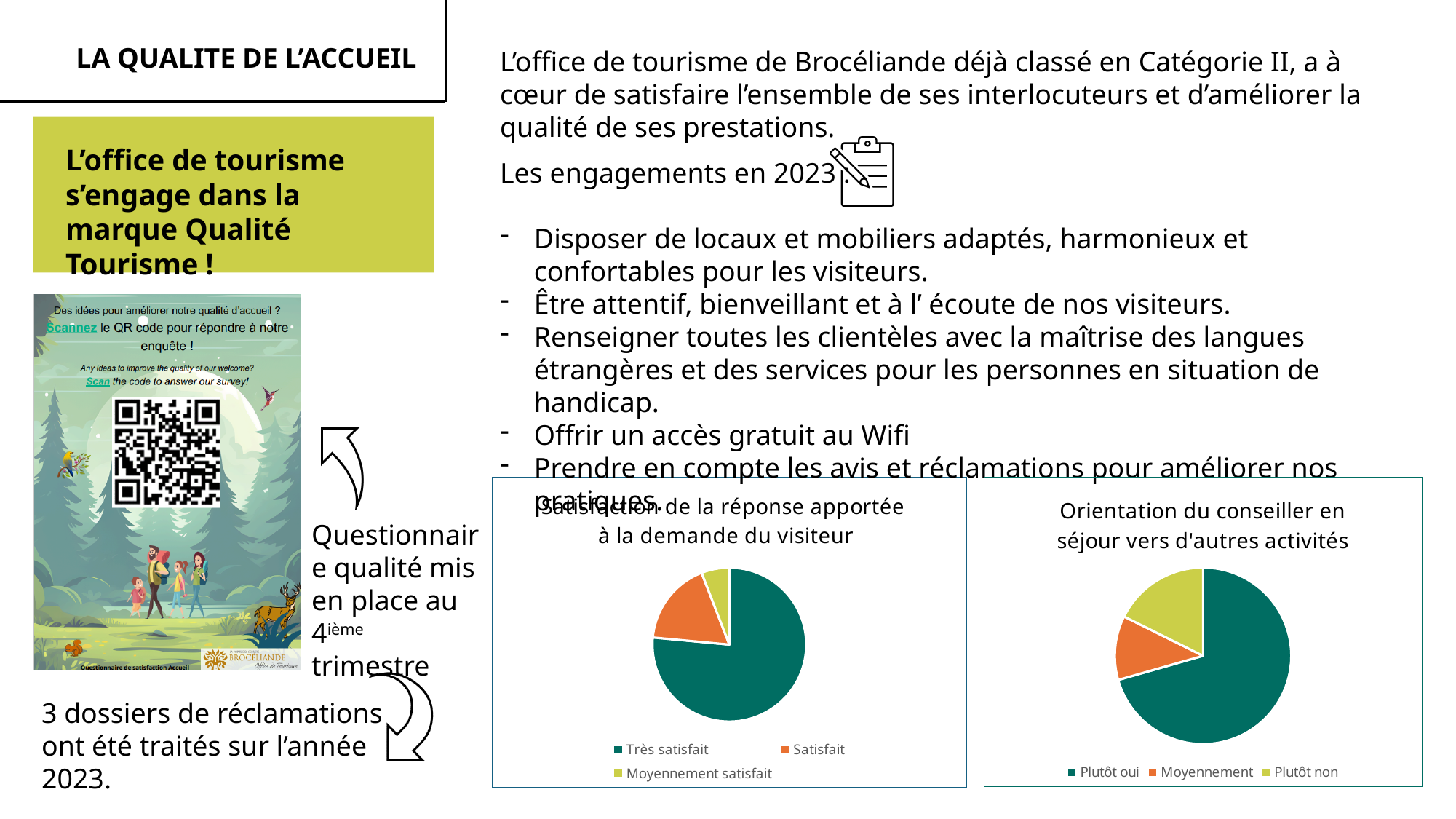
In the 'Satisfaction de la réponse apportée à la demande du visiteur' chart, which category has the smallest slice? Moyennement satisfait In the 'Satisfaction de la réponse apportée à la demande du visiteur' chart, which category has the largest slice? Très satisfait How many pie charts are shown on the slide? 2 What are the legend entries of the 'Orientation du conseiller en séjour vers d'autres activités' chart? Plutôt oui, Moyennement, Plutôt non How many categories does the legend of the 'Satisfaction de la réponse apportée à la demande du visiteur' chart list? 3 In the 'Orientation du conseiller en séjour vers d'autres activités' chart, which category has the largest slice? Plutôt oui In the 'Orientation du conseiller en séjour vers d'autres activités' chart, which slice is larger: Plutôt oui or Plutôt non? Plutôt oui What kind of chart is the 'Satisfaction de la réponse apportée à la demande du visiteur' chart? Pie chart In the 'Satisfaction de la réponse apportée à la demande du visiteur' chart, which slice is larger: Satisfait or Moyennement satisfait? Satisfait How many categories does the legend of the 'Orientation du conseiller en séjour vers d'autres activités' chart list? 3 In the 'Satisfaction de la réponse apportée à la demande du visiteur' chart, what colour is the 'Satisfait' slice? Orange What kind of chart is the 'Orientation du conseiller en séjour vers d'autres activités' chart? Pie chart